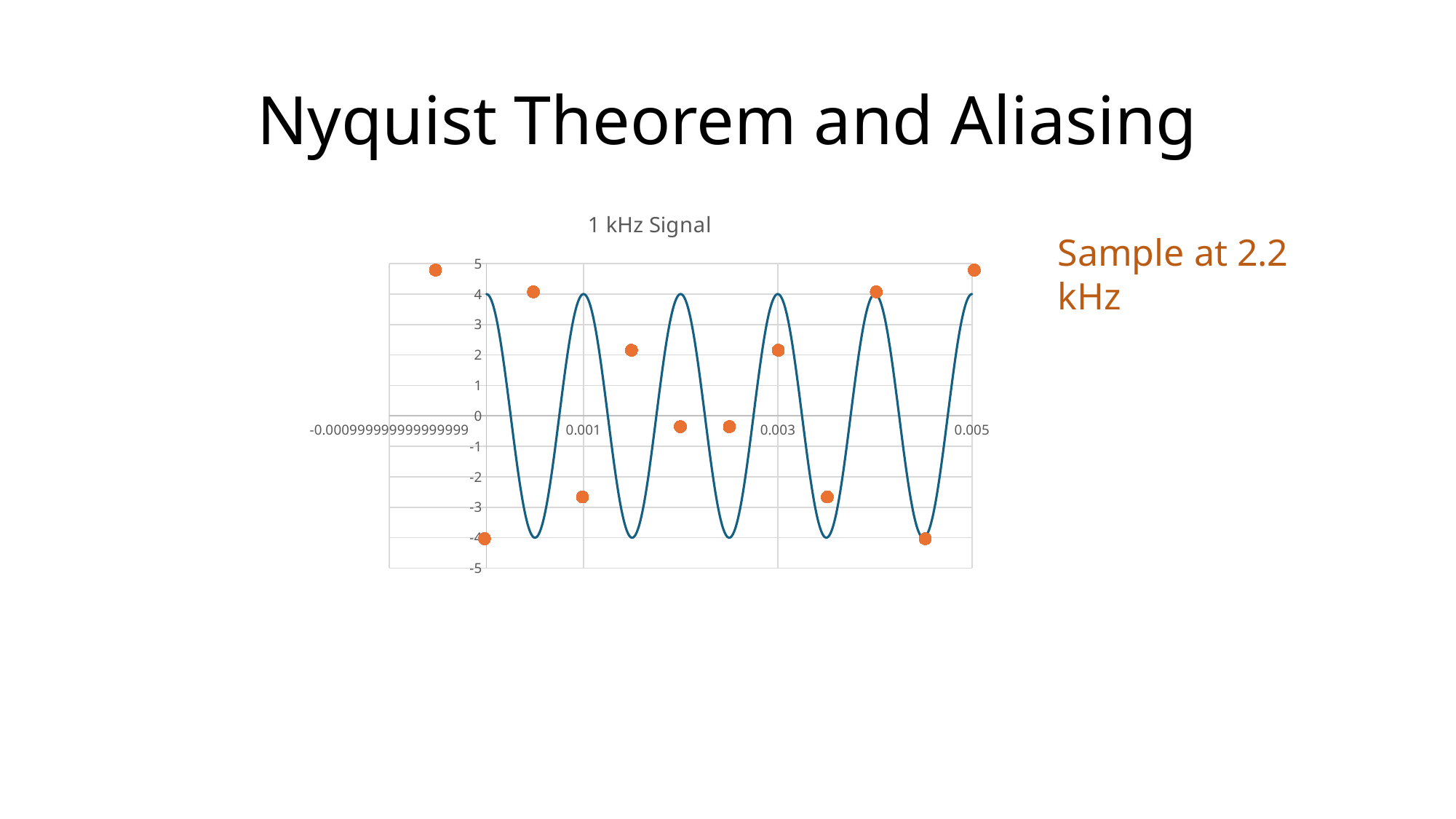
How many orange sample points are plotted on the chart? 12 What kind of chart is shown on the slide? line chart Is the value of the orange sample point at x = 0.001 greater or less than -2? less How many orange sample points lie below 0 on the y axis? 6 What is the maximum value reached by the blue signal curve? 4 What is the title of the chart? 1 kHz Signal What is the highest value shown on the y axis? 5 Is the value of the orange sample point at x = 0.005 greater or less than 4? greater Which is larger: the orange sample point at x = 0.001 or the orange sample point at x = 0.003? the point at x = 0.003 What is the minimum value reached by the blue signal curve? -4 Is the value of the orange sample point at x = 0.003 greater or less than 1? greater